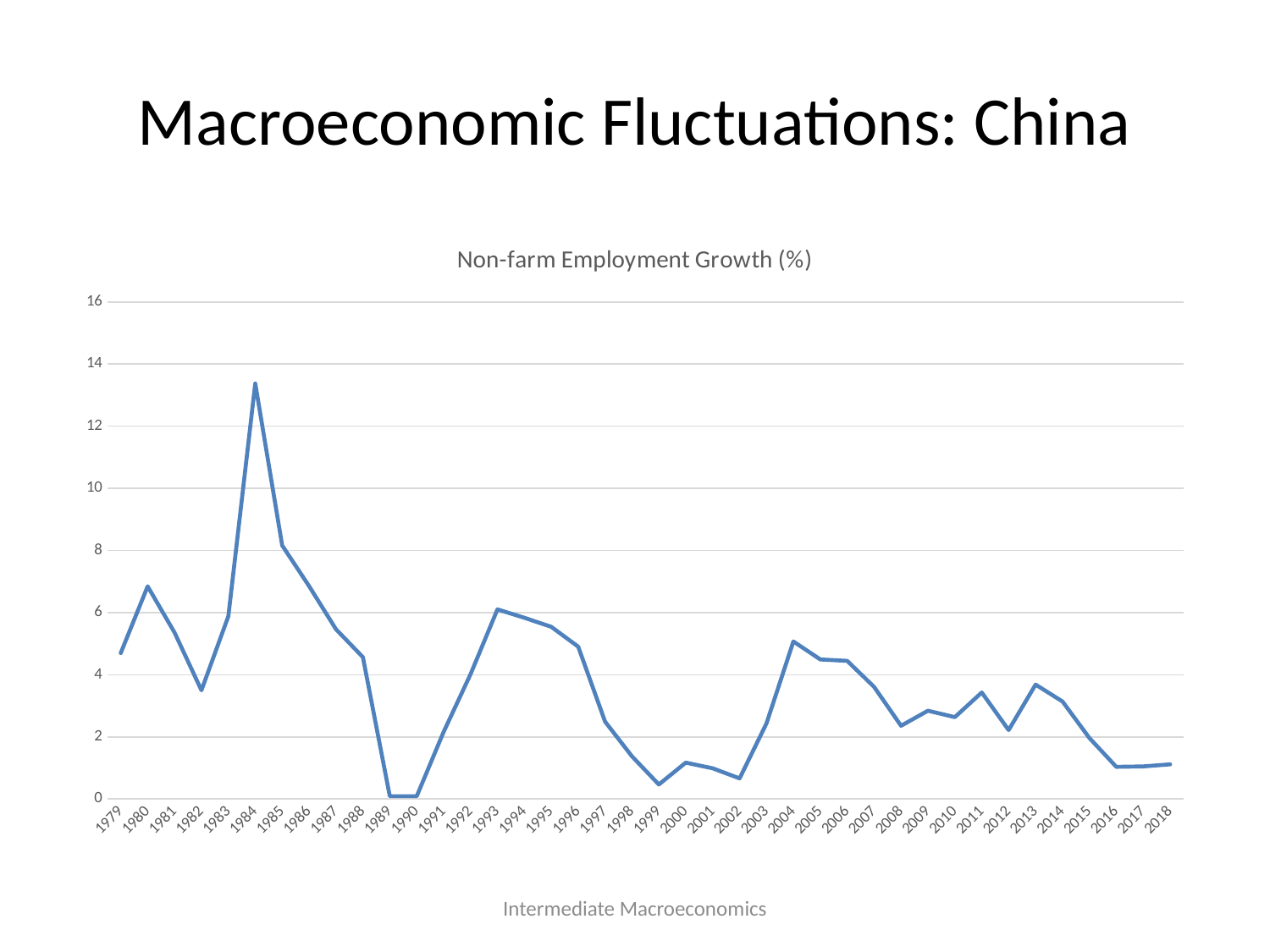
Is the value for 2004 greater or less than 4? greater Which year has the highest non-farm employment growth? 1984 Do the values rise or fall from 1984 to 1989? fall How many years are plotted on the x axis? 40 Is the value for 2016 greater or less than 2? less Is the value for 1980 greater or less than 6? greater What is the title of the chart? Non-farm Employment Growth (%) Which year has the larger value, 1984 or 1993? 1984 Which year has the larger value, 2004 or 2016? 2004 What kind of chart is shown on the slide? Line chart